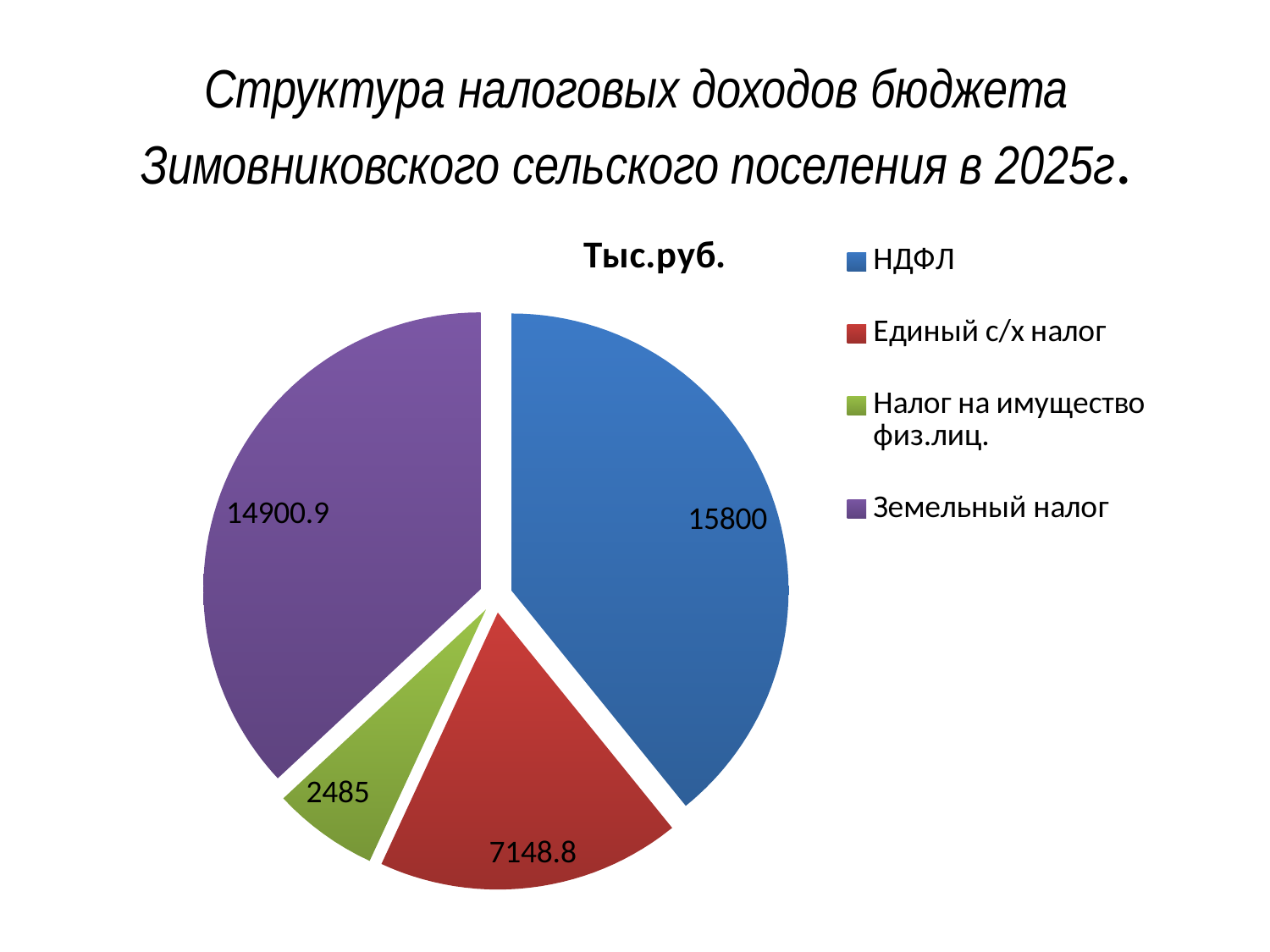
Which category has the largest slice of the pie? НДФЛ What is the value for Налог на имущество физ.лиц.? 2485 What kind of chart is shown on the slide? Pie chart What is the value for Земельный налог? 14900.9 What is the difference between the values for НДФЛ and Земельный налог? 899.1 Which is larger, the value for Единый с/х налог or the value for Налог на имущество физ.лиц.? Единый с/х налог What is the title shown above the pie chart? Тыс.руб. How many categories does the pie chart show? 4 Which category has the smallest slice of the pie? Налог на имущество физ.лиц. What is the value for Единый с/х налог? 7148.8 What is the value for НДФЛ? 15800 What is the difference between the values for Единый с/х налог and Налог на имущество физ.лиц.? 4663.8